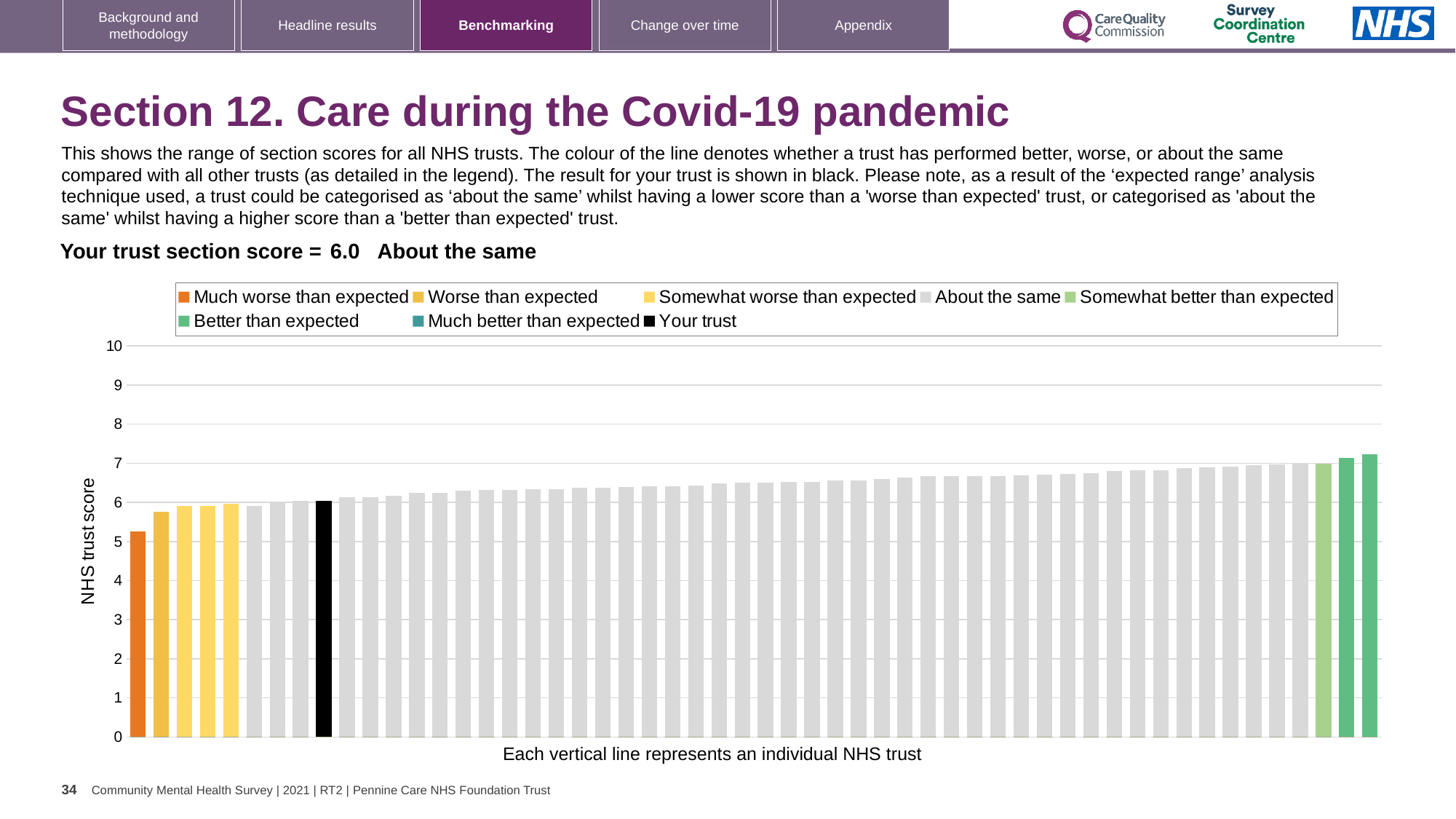
What colour represents 'Your trust' in the chart? black Is the value of the black 'Your trust' bar greater or less than 7? less What kind of chart is shown on the slide? bar chart What is the maximum value shown on the y axis? 10 How is your trust's section score categorised compared with other trusts? About the same Which is larger: the value of the black 'Your trust' bar or the orange 'Much worse than expected' bar? Your trust Is the value of the tallest bar on the chart greater or less than 7? greater How many entries does the chart legend list? 8 Is the value of the orange 'Much worse than expected' bar greater or less than 6? less What is the section score for your trust shown on the slide? 6.0 What is the label of the y axis? NHS trust score Do the bar values rise or fall from left to right along the x axis? rise